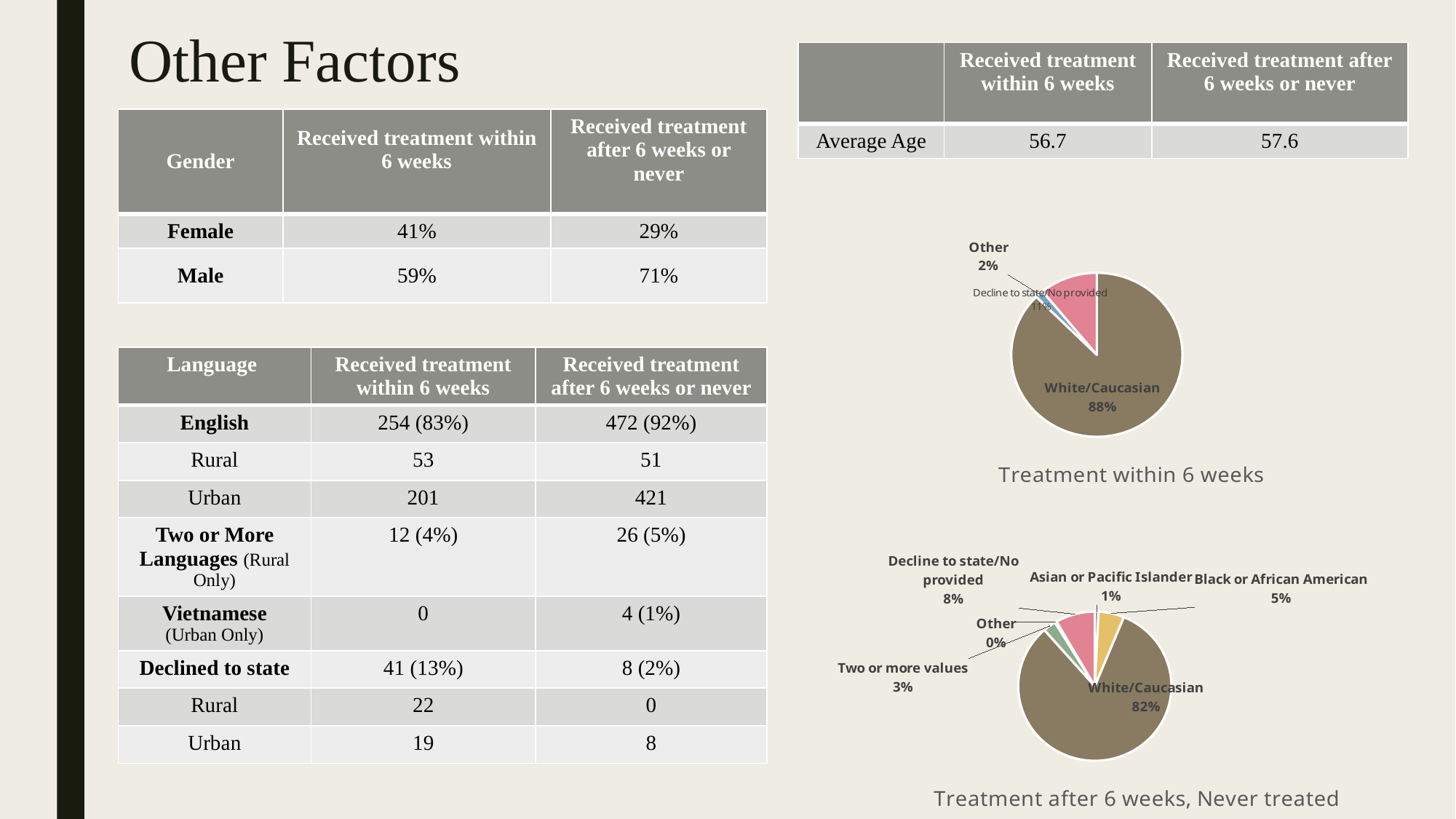
In the 'Treatment within 6 weeks' pie chart, how many percentage points larger is White/Caucasian than Other? 86 In the 'Treatment within 6 weeks' pie chart, what share is labelled Other? 2% Which pie chart shows the larger White/Caucasian share, 'Treatment within 6 weeks' or 'Treatment after 6 weeks, Never treated'? Treatment within 6 weeks In the 'Treatment after 6 weeks, Never treated' pie chart, what share is White/Caucasian? 82% In the 'Treatment after 6 weeks, Never treated' pie chart, what share is Decline to state/No provided? 8% In the 'Treatment within 6 weeks' pie chart, which category has the largest slice? White/Caucasian In the 'Treatment after 6 weeks, Never treated' pie chart, which is larger: Two or more values or Black or African American? Black or African American In the 'Treatment after 6 weeks, Never treated' pie chart, how many categories are labelled? 6 In the 'Treatment after 6 weeks, Never treated' pie chart, what share is Black or African American? 5% In the 'Treatment within 6 weeks' pie chart, what share is White/Caucasian? 88% In the 'Treatment within 6 weeks' pie chart, which category has the smallest slice? Other What type of chart is used for 'Treatment after 6 weeks, Never treated'? Pie chart